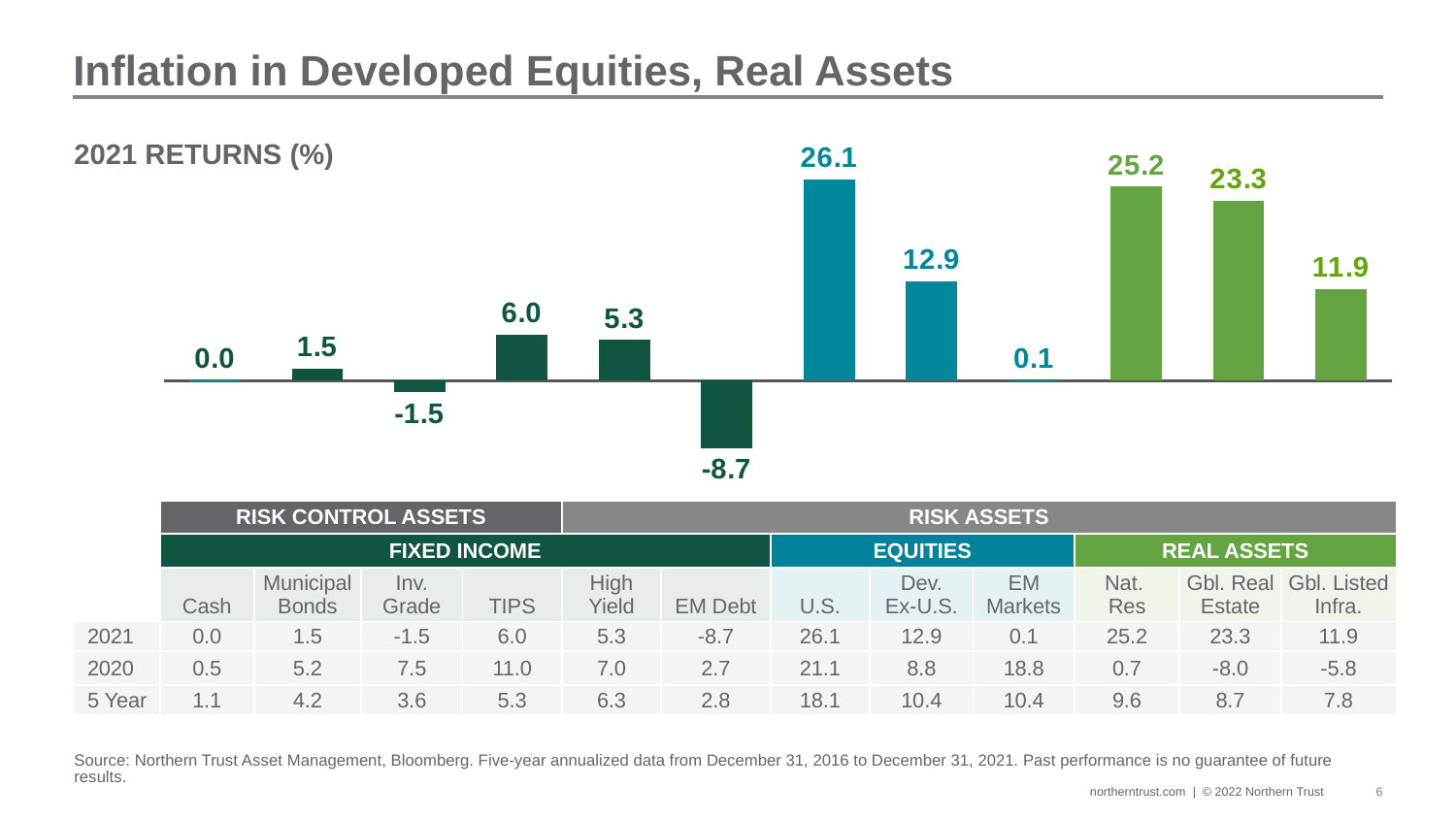
Which category has the lowest 2021 return in the chart? EM Debt What is the 2021 return shown for U.S. equities? 26.1 Which category has the highest 2021 return in the chart? U.S. How many categories are plotted in the 2021 returns chart? 12 Which has the larger 2021 return, Dev. Ex-U.S. or Gbl. Listed Infra.? Dev. Ex-U.S. What is the 2021 return shown for EM Debt? -8.7 What kind of chart is used to show the 2021 returns? Bar chart What is the 2021 return shown for Gbl. Listed Infra.? 11.9 Which has the larger 2021 return, High Yield or TIPS? TIPS What is the difference between the 2021 returns for Nat. Res and Gbl. Real Estate? 1.9 What is the 2021 return shown for TIPS? 6.0 What is the title of the chart on the slide? 2021 RETURNS (%)